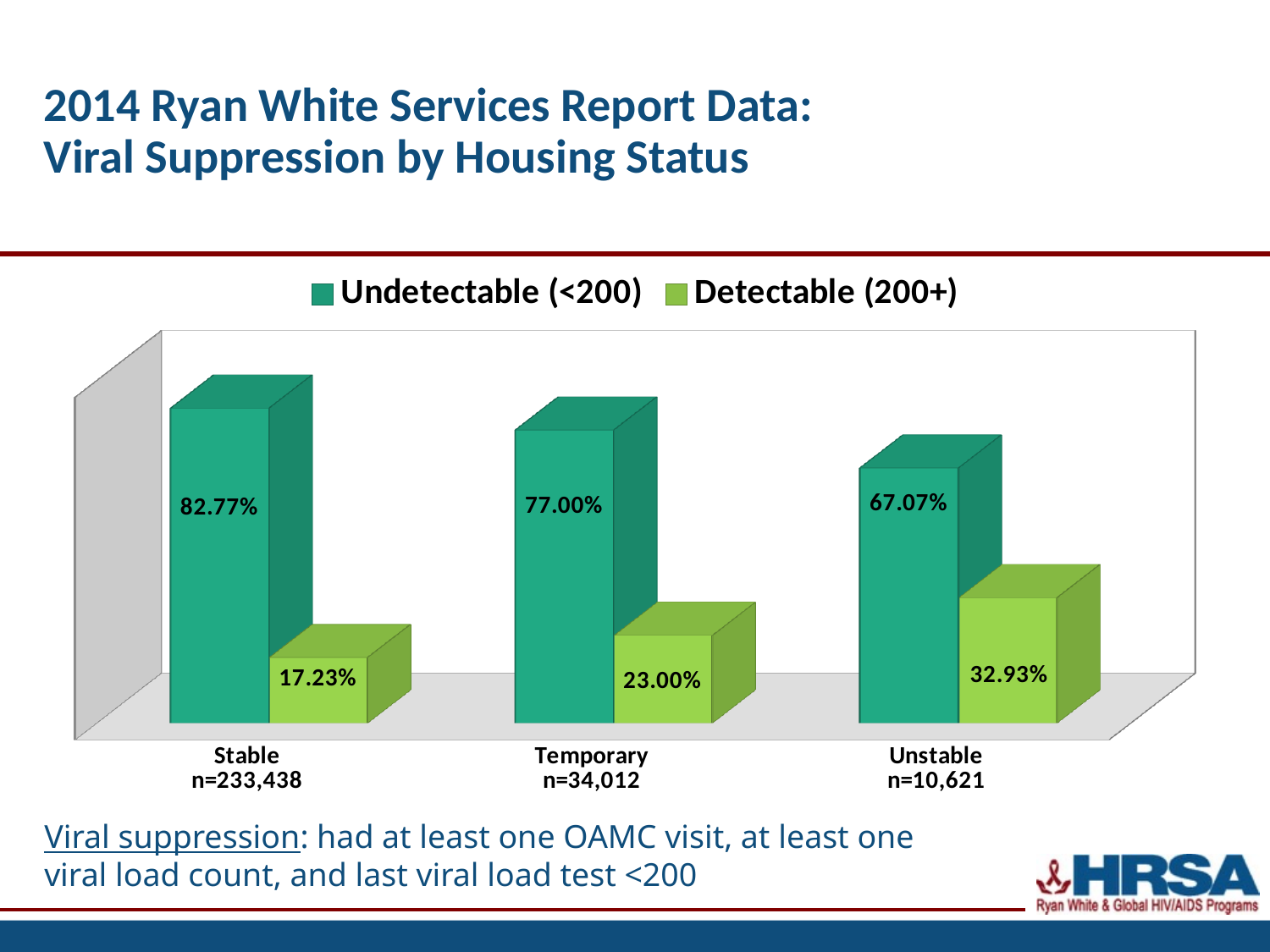
Which housing category has the lowest Detectable (200+) value? Stable What kind of chart is shown on the slide? Bar chart What is the Undetectable (<200) value for the Temporary housing category? 77.00% What is the Undetectable (<200) value for the Stable housing category? 82.77% What is the difference between the Undetectable (<200) values for Stable and Unstable housing? 15.70% Which is larger: the Detectable (200+) value for Temporary or for Unstable housing? Unstable Do the Undetectable (<200) values rise or fall moving from Stable to Unstable housing? Fall Which housing category has the highest Undetectable (<200) value? Stable What is the sample size (n) shown for the Temporary housing category? n=34,012 What is the Detectable (200+) value for the Unstable housing category? 32.93% How many housing status categories are shown on the x axis? 3 How many series does the legend list? 2